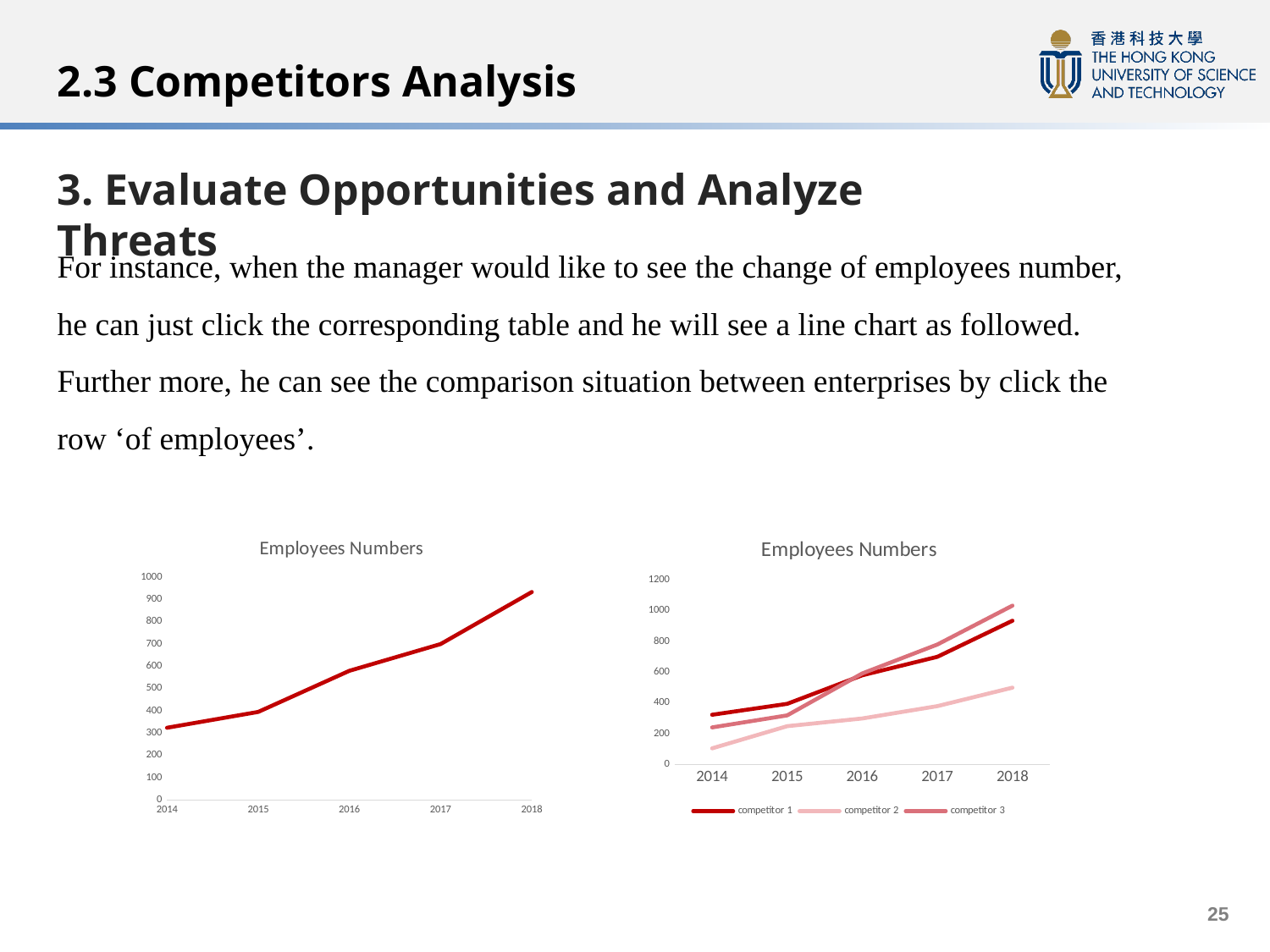
In the left chart, is the value for 2018 greater or less than 800? greater In the right chart, is the value for competitor 2 in 2018 greater or less than 600? less In the left chart, is the value for 2014 greater or less than 400? less In the left chart, which year has the lowest employee number? 2014 In the right chart, which is larger in 2014: competitor 1 or competitor 2? competitor 1 How many series does the legend of the right chart list? 3 What kind of chart is the left chart titled 'Employees Numbers'? line chart How many years are plotted along the x axis of the left chart? 5 What is the title of the right chart? Employees Numbers In the left chart, do employee numbers rise or fall from 2014 to 2018? rise In the right chart, which series has the highest value in 2018? competitor 3 In the left chart, which year has the highest employee number? 2018